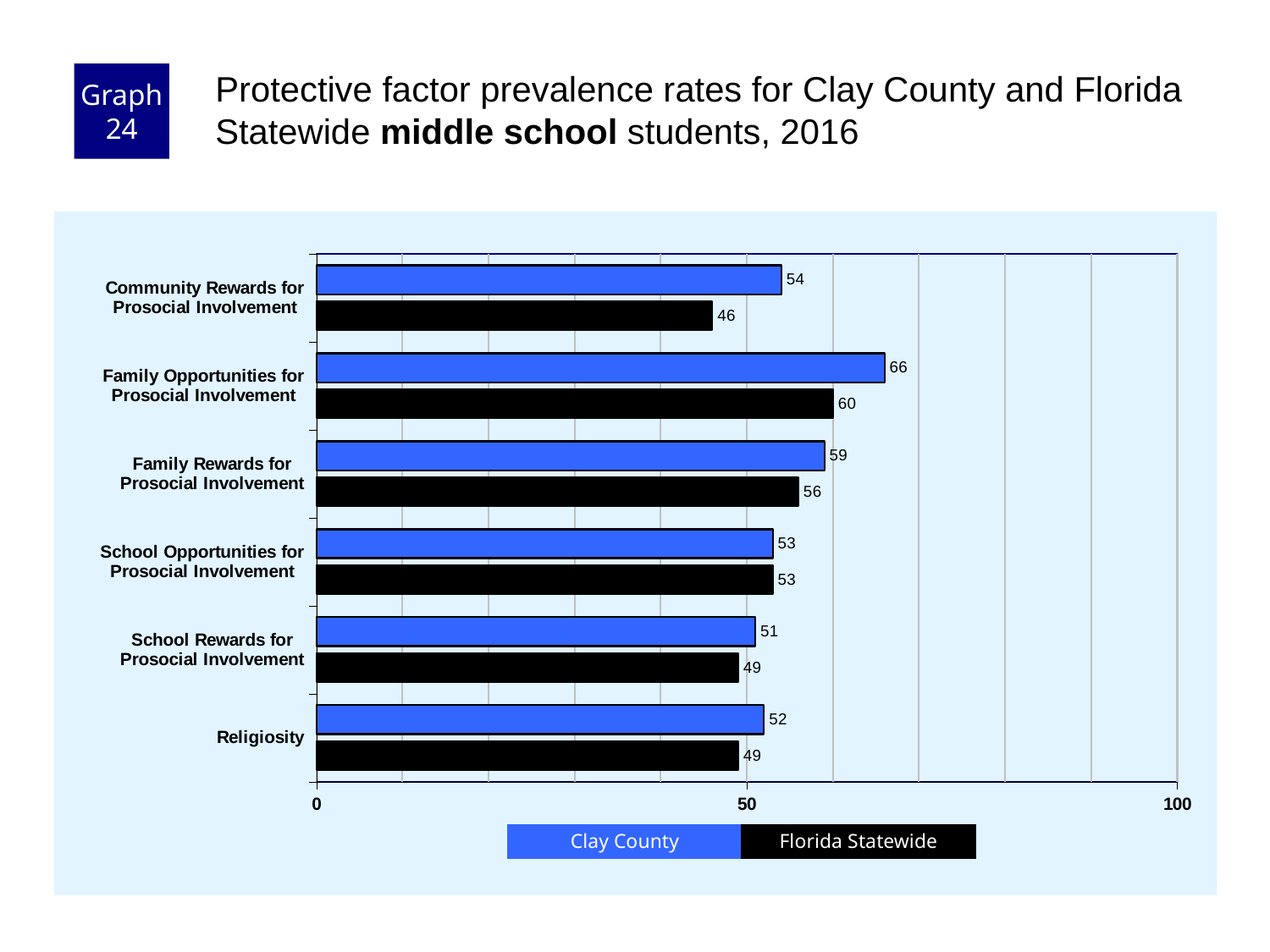
Which category has the highest Clay County value? Family Opportunities for Prosocial Involvement What is the Florida Statewide value for Religiosity? 49 How many categories are shown on the chart? 6 Which colour represents Florida Statewide in the chart? black Is the Florida Statewide value for Family Opportunities for Prosocial Involvement greater or less than 50? greater Which is larger for Family Rewards for Prosocial Involvement: the Clay County value or the Florida Statewide value? Clay County What is the Florida Statewide value for Community Rewards for Prosocial Involvement? 46 How many series does the legend list? 2 What is the Clay County value for Family Opportunities for Prosocial Involvement? 66 What is the difference between the Clay County and Florida Statewide values for Community Rewards for Prosocial Involvement? 8 What kind of chart is shown on the slide? bar chart Which category has the lowest Florida Statewide value? Community Rewards for Prosocial Involvement